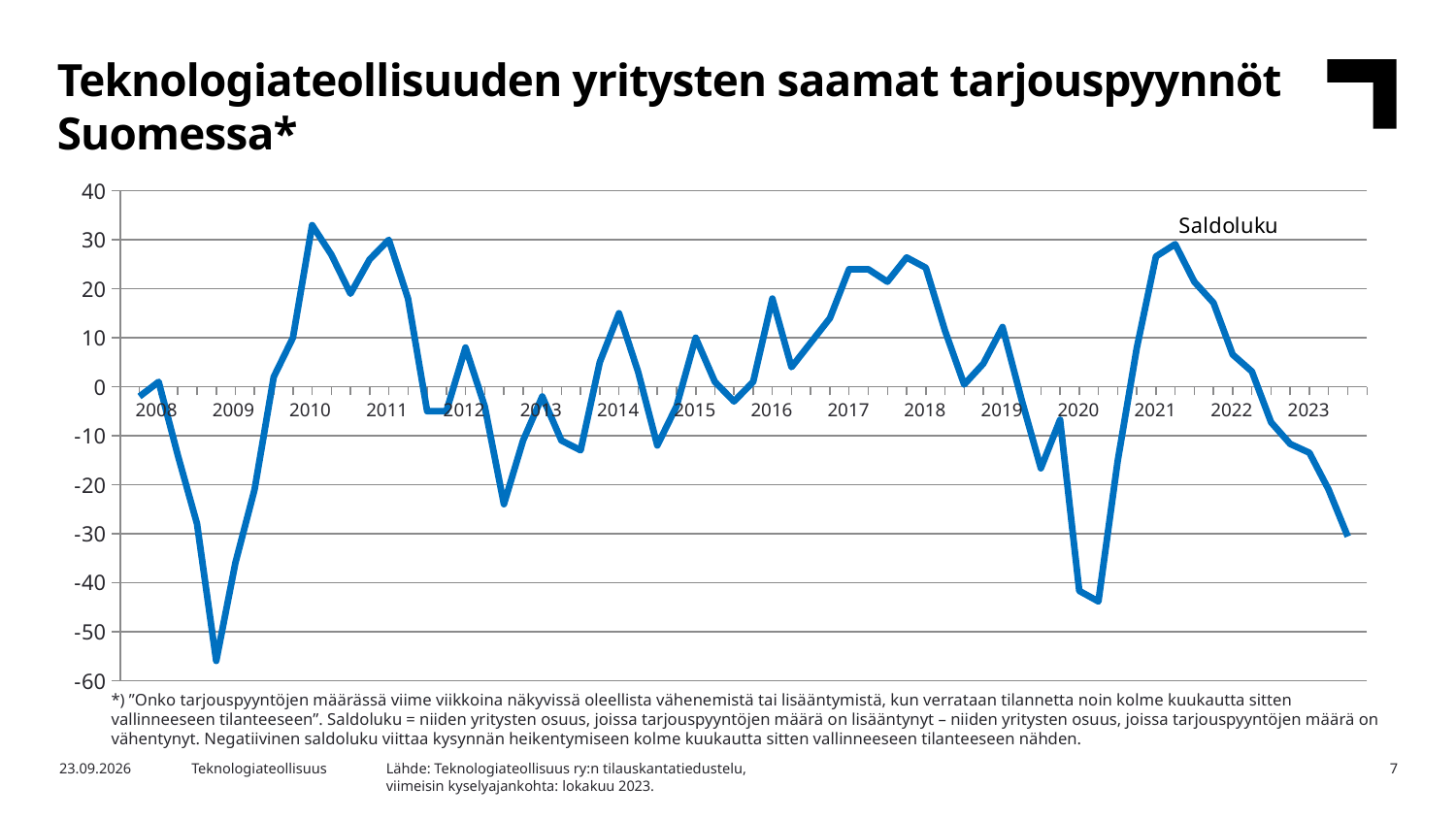
What is the name of the series plotted on the chart? Saldoluku Does the line rise or fall between its 2009 low and its 2010 peak? rise What kind of chart is shown on the slide? line chart Is the lowest value of the line in 2020 greater or less than -40? less Is the peak value of the line in 2018 greater or less than 20? greater What is the title of the chart on the slide? Teknologiateollisuuden yritysten saamat tarjouspyynnöt Suomessa* Is the lowest value of the line in 2012 greater or less than -20? less In which year does the line reach its lowest value? 2009 Does the line rise or fall between its 2021 peak and the end of 2023? fall How many years are labelled on the x axis of the chart? 16